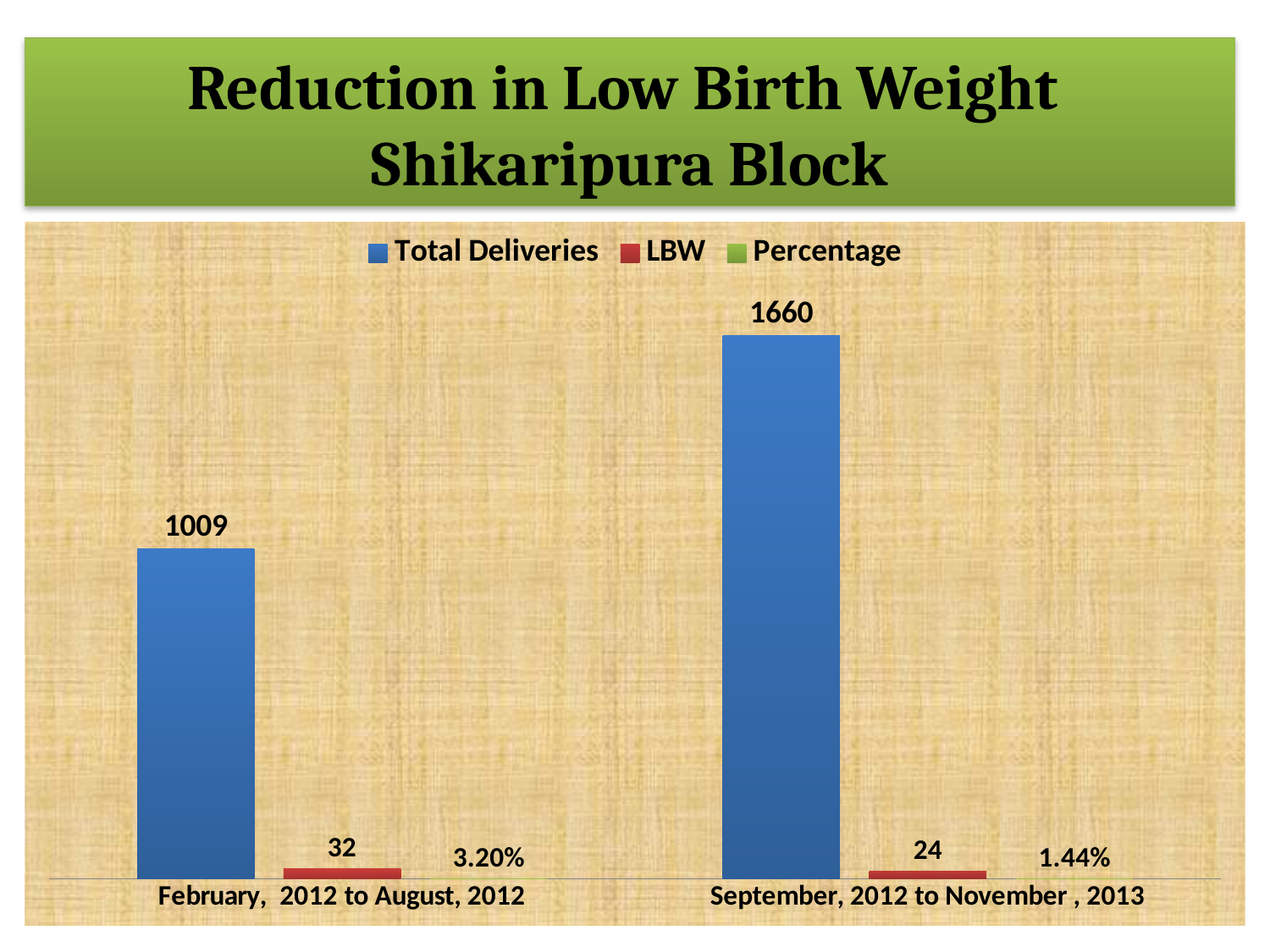
What is the LBW value for September, 2012 to November, 2013? 24 What is the LBW value for February, 2012 to August, 2012? 32 How many series does the legend list? 3 Which period has the lower LBW value? September, 2012 to November, 2013 What is the Percentage value for September, 2012 to November, 2013? 1.44% What is the value of Total Deliveries for September, 2012 to November, 2013? 1660 What is the difference in LBW between February, 2012 to August, 2012 and September, 2012 to November, 2013? 8 What is the difference in Total Deliveries between the two periods? 651 What is the Percentage value for February, 2012 to August, 2012? 3.20% Which period has the higher Total Deliveries? September, 2012 to November, 2013 What is the value of Total Deliveries for February, 2012 to August, 2012? 1009 What kind of chart is shown on the slide? Bar chart